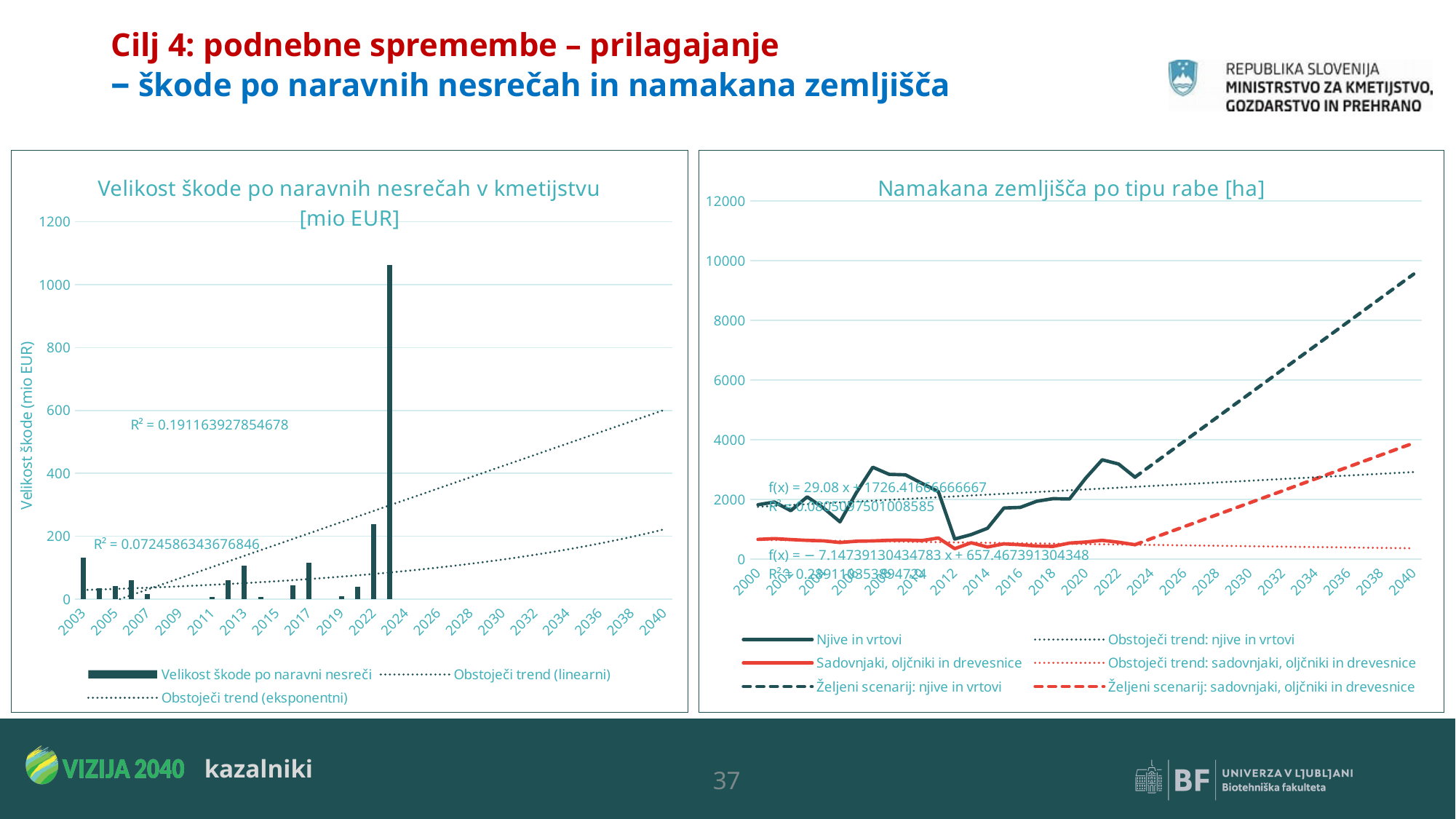
On the right chart, is the value for Željeni scenarij: njive in vrtovi in 2040 greater or less than 8000? greater On the right chart, does the Željeni scenarij: njive in vrtovi line rise or fall from 2024 to 2040? rise What kind of chart is the left chart, 'Velikost škode po naravnih nesrečah v kmetijstvu [mio EUR]'? bar chart On the right chart, is the value for Željeni scenarij: sadovnjaki, oljčniki in drevesnice in 2040 greater or less than 2000? greater On the left chart, is the value for Velikost škode po naravni nesreči in 2003 greater or less than 200? less What is the y-axis title of the left chart? Velikost škode (mio EUR) How many series does the legend of the left chart list? 3 What kind of chart is the right chart, 'Namakana zemljišča po tipu rabe [ha]'? line chart How many series does the legend of the right chart list? 6 What is the larger of the two R² values printed on the left chart? R² = 0.191163927854678 On the right chart, which is higher in 2040: Željeni scenarij: njive in vrtovi or Željeni scenarij: sadovnjaki, oljčniki in drevesnice? Željeni scenarij: njive in vrtovi